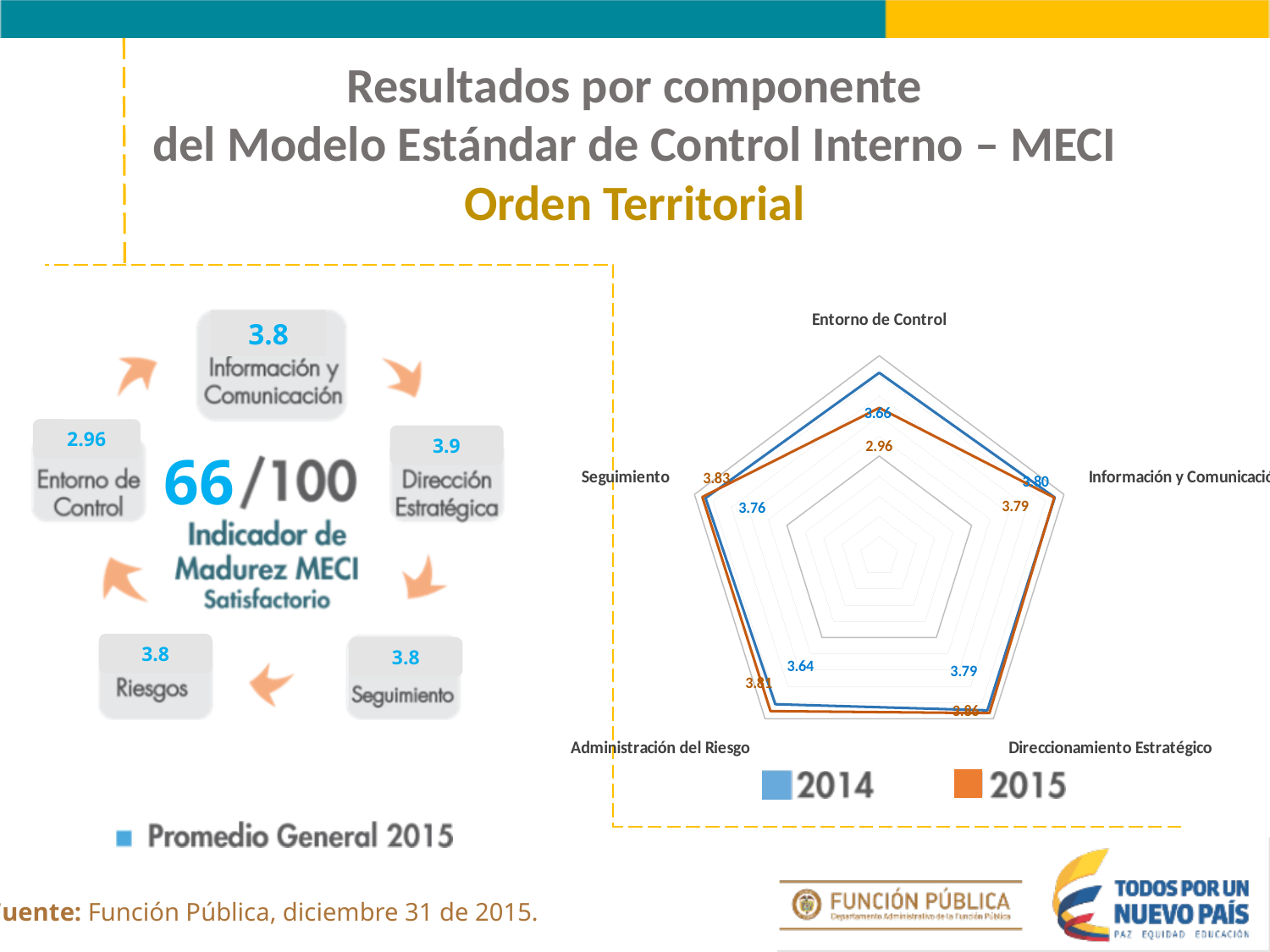
In the radar chart, what is the difference between the 2015 and 2014 values for Seguimiento? 0.07 In the radar chart, which component has the lowest 2015 value? Entorno de Control In the radar chart, what is the 2014 value for Direccionamiento Estratégico? 3.79 How many components (axes) does the radar chart have? 5 In the radar chart, what is the 2014 value for Seguimiento? 3.76 In the radar chart, what is the 2015 value for Entorno de Control? 2.96 How many series does the legend of the radar chart list? 2 In the radar chart, what is the 2014 value for Administración del Riesgo? 3.64 In the radar chart, which year has the higher value for Seguimiento, 2014 or 2015? 2015 What kind of chart is shown on the right side of the slide? radar chart In the radar chart, what is the 2015 value for Seguimiento? 3.83 In the radar chart, which colour represents the 2015 series? orange